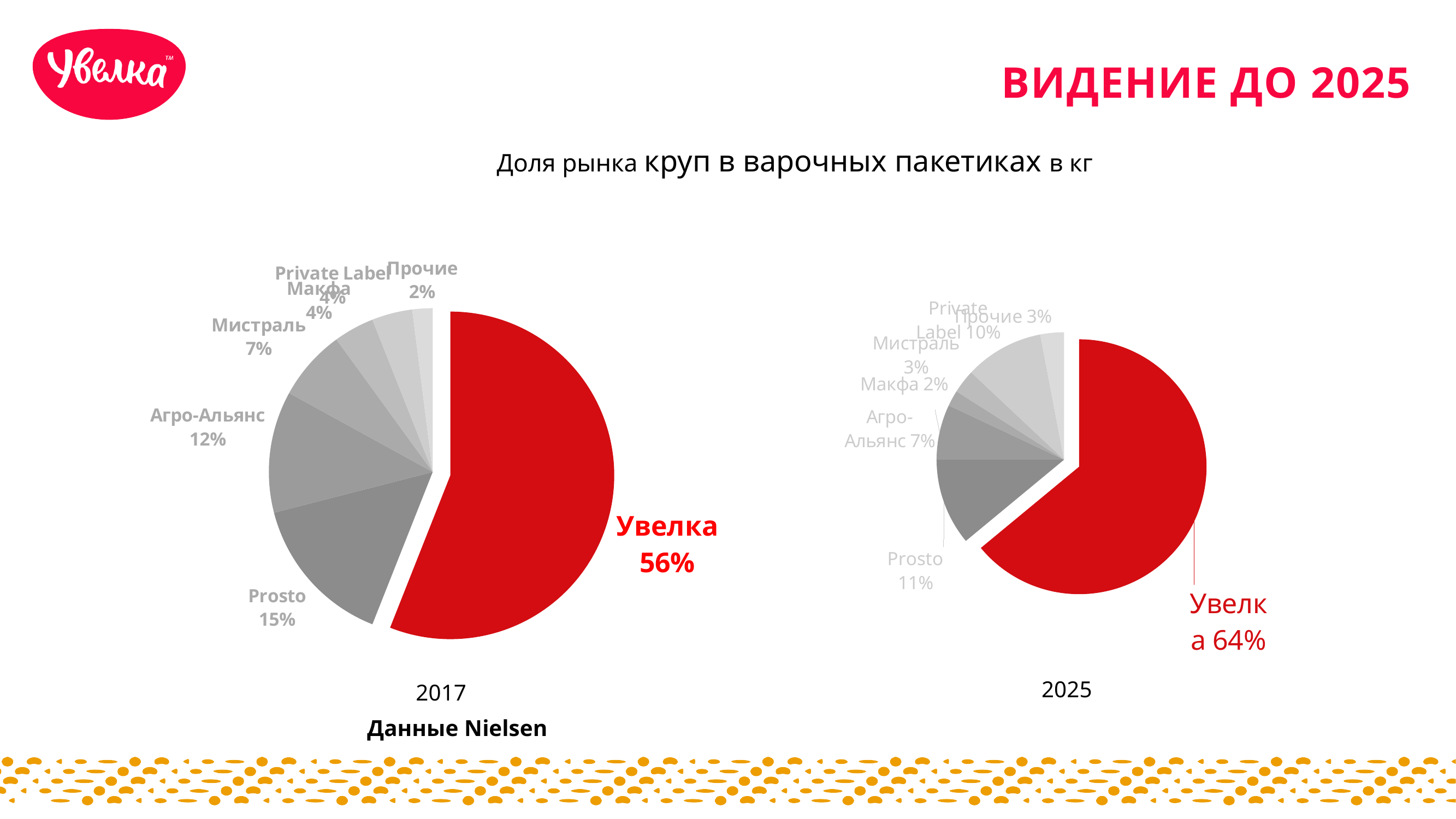
How many slices does the 2017 pie chart have? 7 In the 2017 pie chart, which brand has the largest share? Увелка In the 2025 pie chart, what is the market share of Увелка? 64% What kind of chart is used for the 2017 market share? Pie chart By how many percentage points does Увелка's share grow from the 2017 pie chart to the 2025 pie chart? 8 In the 2017 pie chart, what is the market share of Увелка? 56% In the 2025 pie chart, what is the share of Private Label? 10% In the 2017 pie chart, which category has the smallest share? Прочие In the 2025 pie chart, which is larger: the share of Prosto or the share of Агро-Альянс? Prosto In the 2017 pie chart, what is the share of Prosto? 15% In the 2017 pie chart, what is the share of Агро-Альянс? 12% In the 2025 pie chart, which brand has the smallest share? Макфа